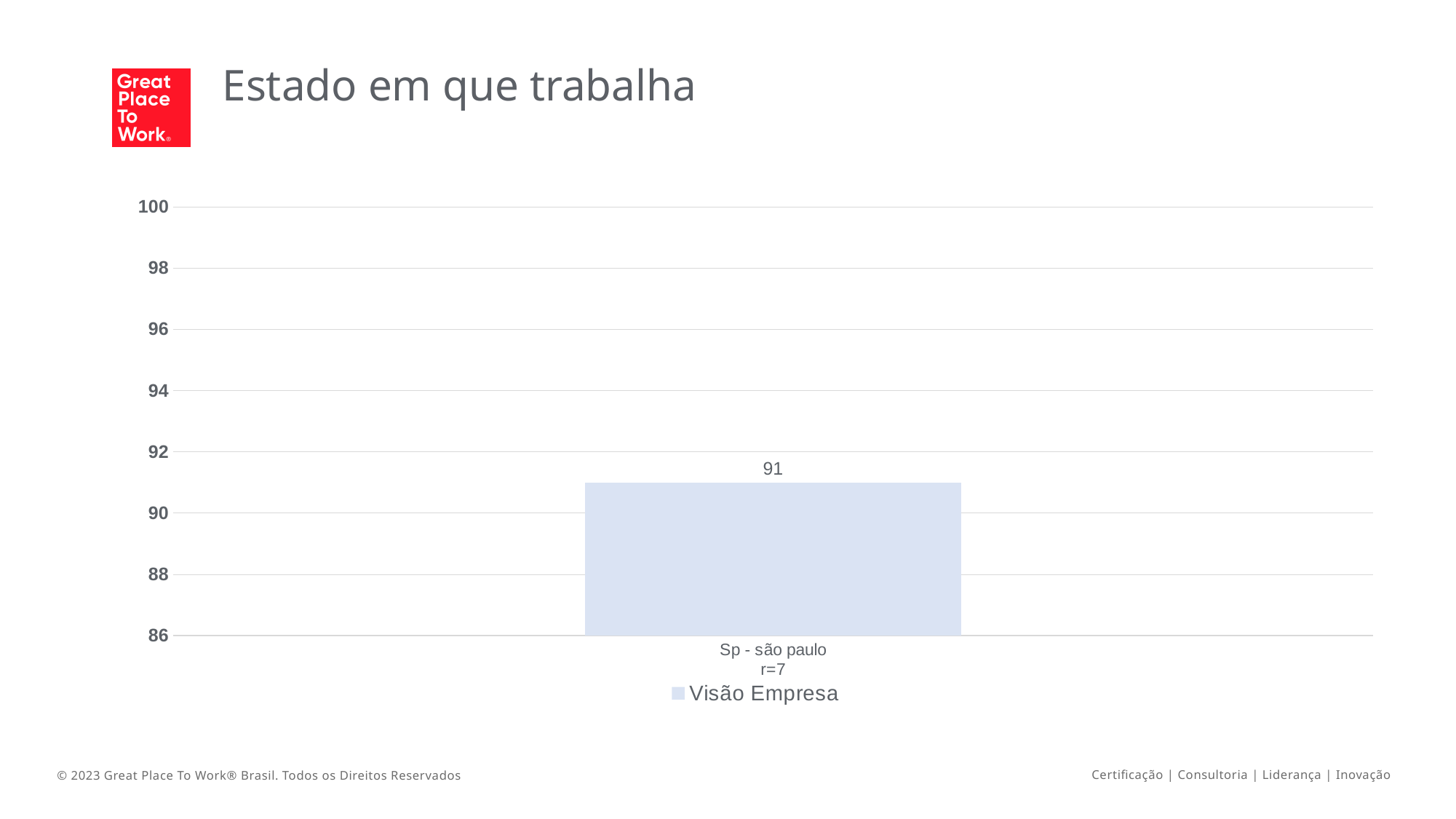
What is the highest value shown on the vertical axis? 100 What is the title of the chart slide? Estado em que trabalha What is the lowest value shown on the vertical axis? 86 How many categories are plotted on the chart? 1 How many series does the legend list? 1 Is the value for Sp - são paulo greater or less than 92? less What series name is shown in the legend? Visão Empresa What is the respondent count (r) shown under the Sp - são paulo category label? r=7 Is the value for Sp - são paulo greater or less than 90? greater What is the value for Sp - são paulo? 91 What kind of chart is shown on the slide? bar chart